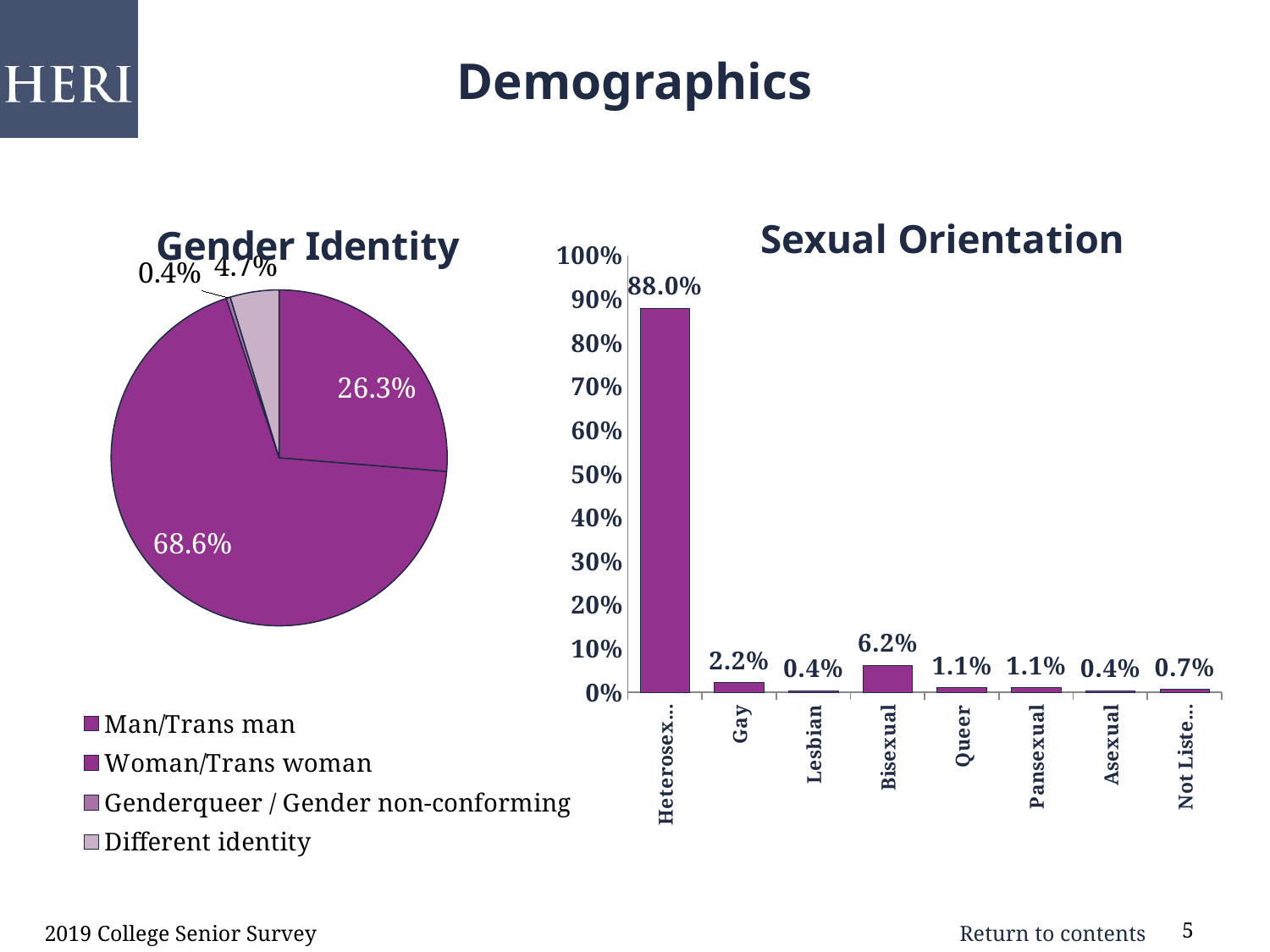
In the Sexual Orientation chart, which is larger, Queer or Lesbian? Queer How many entries does the legend of the Gender Identity chart list? 4 In the Gender Identity pie chart, what share does the largest slice have? 68.6% In the Sexual Orientation chart, what percentage is shown for Gay? 2.2% In the Gender Identity pie chart, what share is shown for Different identity? 4.7% How many categories are shown in the Sexual Orientation bar chart? 8 What type of chart is the Sexual Orientation chart? bar chart In the Sexual Orientation chart, what is the difference between the Bisexual and Gay percentages? 4.0% In the Sexual Orientation chart, is the value for Heterosexual greater or less than 80%? greater What type of chart is the Gender Identity chart? pie chart In the Sexual Orientation chart, what percentage is shown for Bisexual? 6.2% In the Sexual Orientation chart, which category has the highest value? Heterosexual